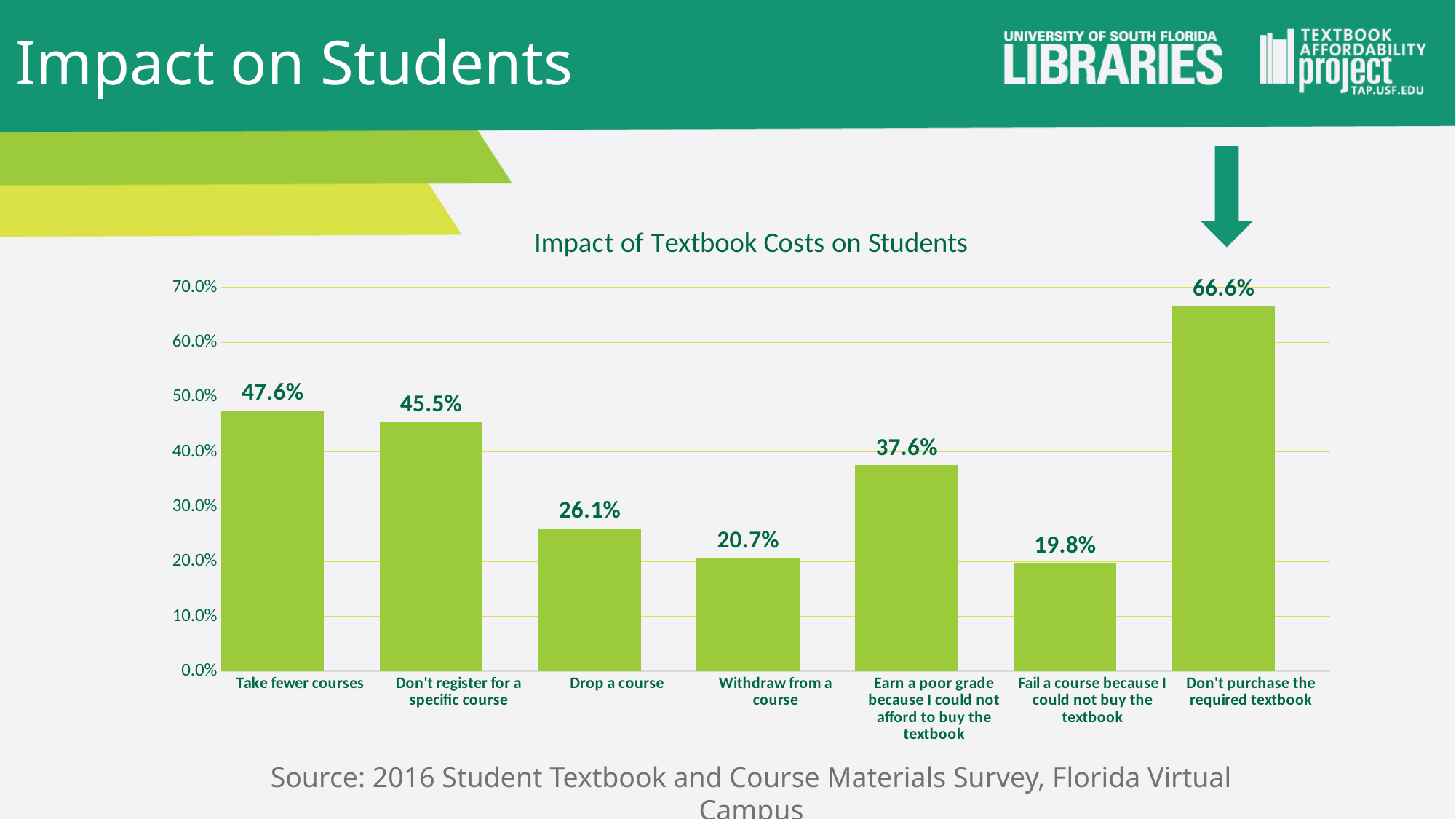
Which category has the highest value? Don't purchase the required textbook What type of chart is shown on the slide? bar chart What is the difference between "Don't purchase the required textbook" and "Fail a course because I could not buy the textbook"? 46.8% Which is larger: "Drop a course" or "Earn a poor grade because I could not afford to buy the textbook"? Earn a poor grade because I could not afford to buy the textbook How many categories are shown in the chart? 7 What is the difference between "Take fewer courses" and "Don't register for a specific course"? 2.1% Is the value for "Drop a course" greater or less than 30.0%? less What percentage of students reported that they take fewer courses due to textbook costs? 47.6% What is the value for "Don't purchase the required textbook"? 66.6% What percentage of students said they withdraw from a course? 20.7% Which category has the lowest value? Fail a course because I could not buy the textbook What is the title of the chart? Impact of Textbook Costs on Students